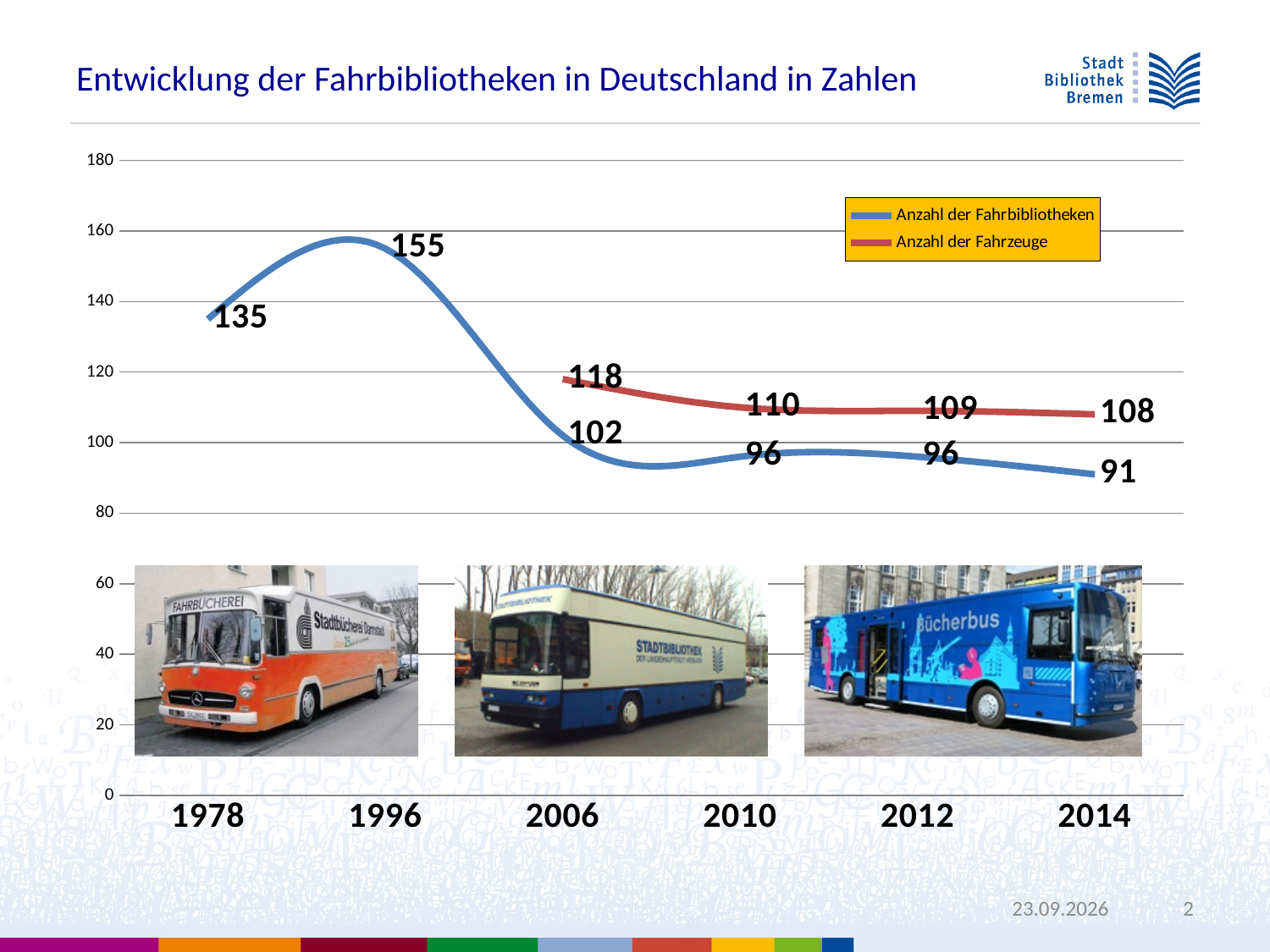
Does Anzahl der Fahrzeuge rise or fall from 2006 to 2014? fall What is the value of Anzahl der Fahrbibliotheken in 2014? 91 What is the value of Anzahl der Fahrzeuge in 2006? 118 What is the value of Anzahl der Fahrbibliotheken in 1996? 155 In which year is Anzahl der Fahrbibliotheken lowest? 2014 What kind of chart is shown on the slide? line chart How many years are shown on the x axis? 6 How many series does the legend list? 2 Which is larger in 2010: Anzahl der Fahrzeuge or Anzahl der Fahrbibliotheken? Anzahl der Fahrzeuge Which colour is used for the Anzahl der Fahrzeuge line? red What is the difference between Anzahl der Fahrbibliotheken in 1996 and in 2006? 53 In which year is Anzahl der Fahrbibliotheken highest? 1996